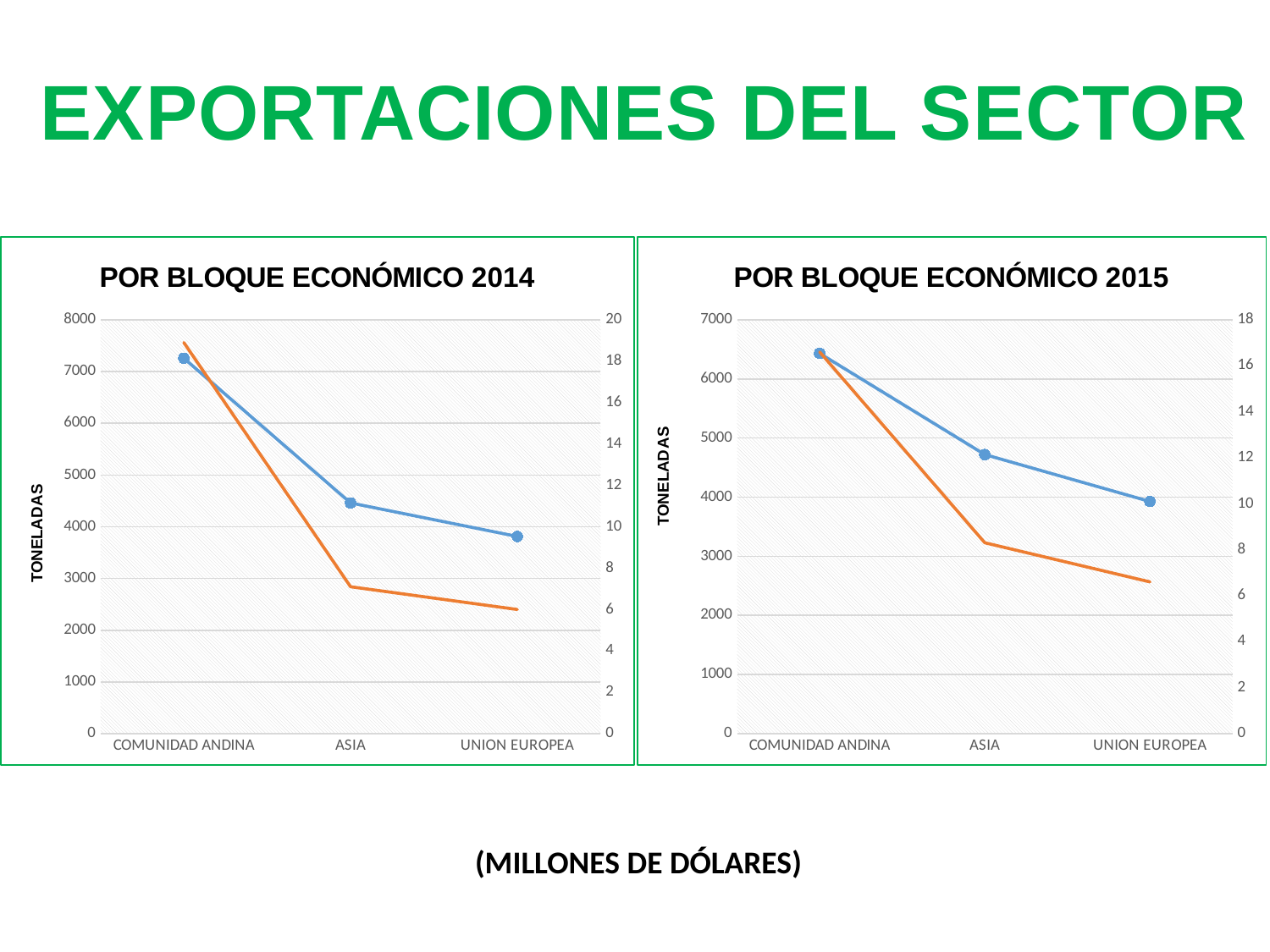
In the "POR BLOQUE ECONÓMICO 2014" chart, do the values of the blue line rise or fall from COMUNIDAD ANDINA to UNION EUROPEA? fall In the "POR BLOQUE ECONÓMICO 2015" chart, which category has the highest value on the blue line? COMUNIDAD ANDINA In the "POR BLOQUE ECONÓMICO 2014" chart, which is larger on the blue line, ASIA or UNION EUROPEA? ASIA What is the label of the left vertical axis on the "POR BLOQUE ECONÓMICO 2015" chart? TONELADAS In the "POR BLOQUE ECONÓMICO 2015" chart, is the orange line value for UNION EUROPEA greater or less than 8 on the right axis? less In the "POR BLOQUE ECONÓMICO 2014" chart, which category has the lowest value on the orange line? UNION EUROPEA In the "POR BLOQUE ECONÓMICO 2014" chart, is the blue line value for COMUNIDAD ANDINA greater or less than 7000 on the left axis? greater In the "POR BLOQUE ECONÓMICO 2014" chart, is the blue line value for ASIA greater or less than 5000 on the left axis? less What is the title of the chart on the right side of the slide? POR BLOQUE ECONÓMICO 2015 What kind of chart is "POR BLOQUE ECONÓMICO 2014"? line chart How many categories are shown on the x axis of the "POR BLOQUE ECONÓMICO 2015" chart? 3